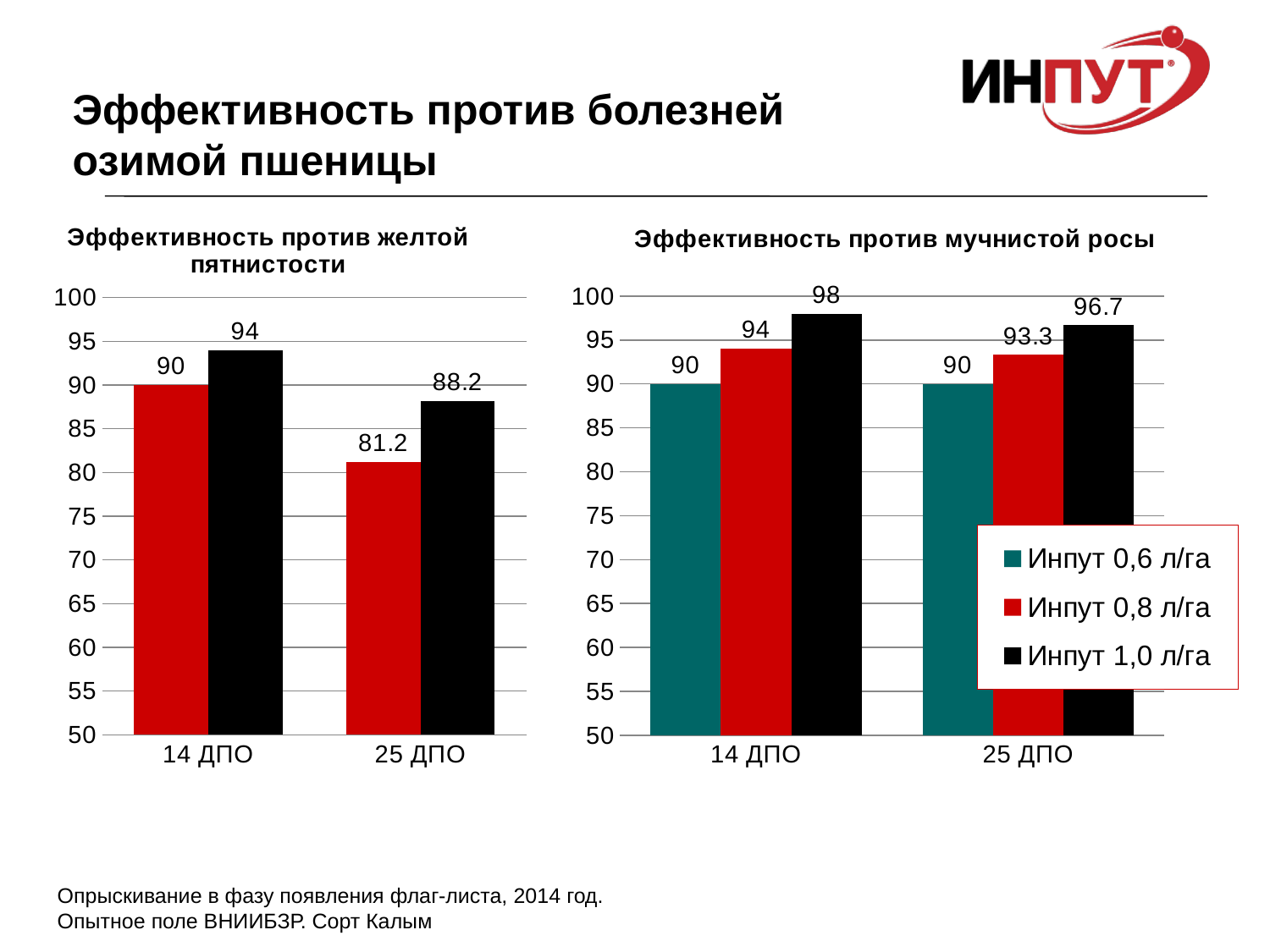
How many series does the legend of the chart 'Эффективность против мучнистой росы' list? 3 In the chart 'Эффективность против мучнистой росы', what is the value for Инпут 0,8 л/га at 25 ДПО? 93.3 In the chart 'Эффективность против желтой пятнистости', what is the value of the red bar at 25 ДПО? 81.2 In the chart 'Эффективность против мучнистой росы', what is the value for Инпут 1,0 л/га at 14 ДПО? 98 In the chart 'Эффективность против мучнистой росы', which series has the highest value at 25 ДПО? Инпут 1,0 л/га How many categories are shown on the x axis of the chart 'Эффективность против желтой пятнистости'? 2 What type of chart is 'Эффективность против мучнистой росы'? Bar chart In the chart 'Эффективность против желтой пятнистости', what is the value of the black bar at 25 ДПО? 88.2 In the chart 'Эффективность против мучнистой росы', what is the difference between Инпут 1,0 л/га and Инпут 0,6 л/га at 14 ДПО? 8 In the chart 'Эффективность против желтой пятнистости', what is the difference between the black and red bars at 25 ДПО? 7 In the chart 'Эффективность против желтой пятнистости', which bar is the lowest across both categories? The red bar at 25 ДПО (81.2) In the chart 'Эффективность против мучнистой росы', is the value for Инпут 1,0 л/га higher at 14 ДПО or at 25 ДПО? 14 ДПО